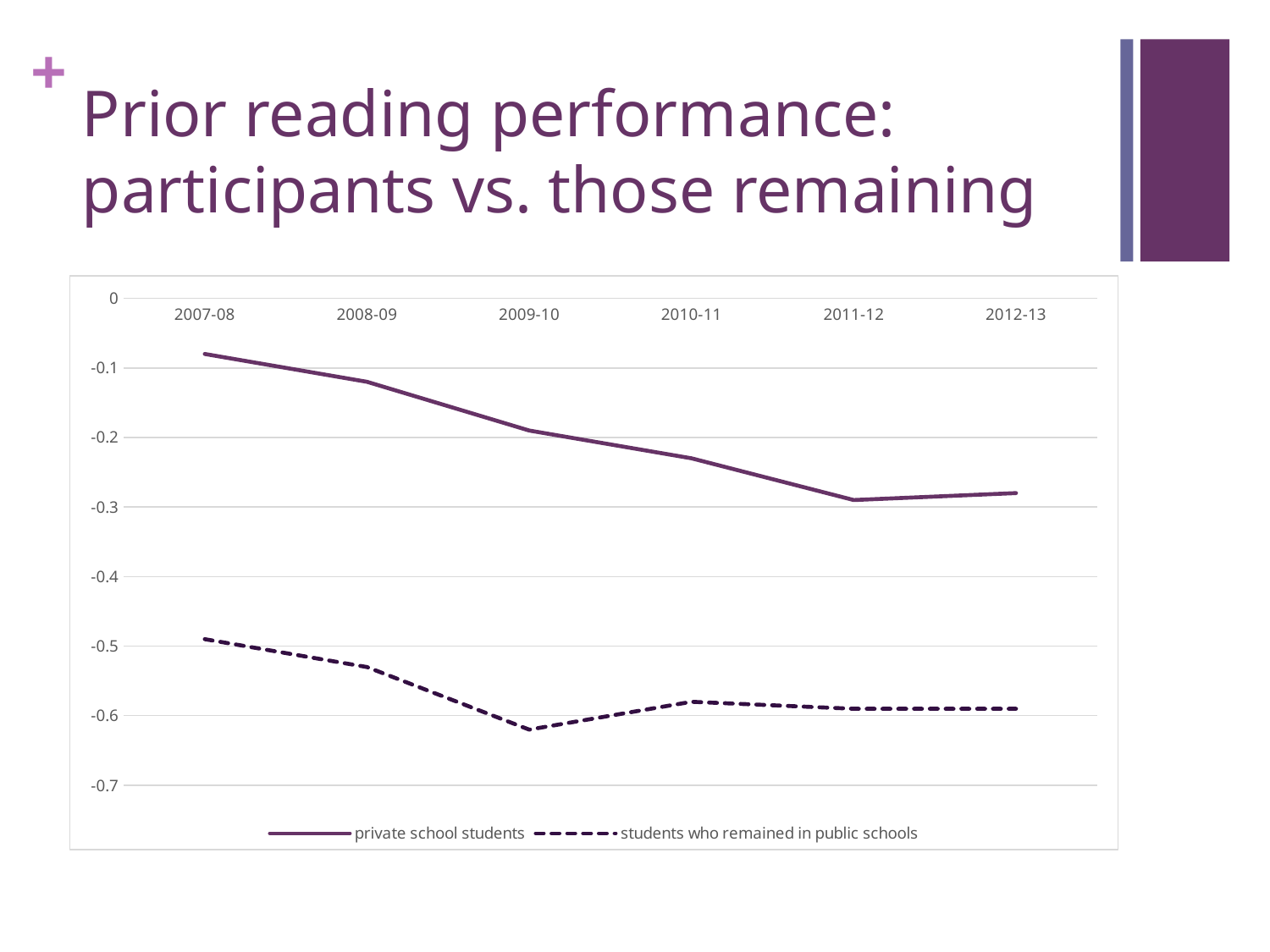
Does the private school students line rise or fall from 2007-08 to 2011-12? fall Is the value for students who remained in public schools in 2008-09 greater or less than -0.5? less Is the value for private school students in 2007-08 greater or less than -0.1? greater In which school year is the value for private school students highest? 2007-08 How many series does the legend list? 2 How many school years are plotted along the x axis? 6 What kind of chart is shown on the slide? line chart Is the value for students who remained in public schools in 2010-11 greater or less than -0.6? greater Which series is drawn with a dashed line? students who remained in public schools In which school year is the value for students who remained in public schools lowest? 2009-10 In 2012-13, which series has the higher value: private school students or students who remained in public schools? private school students